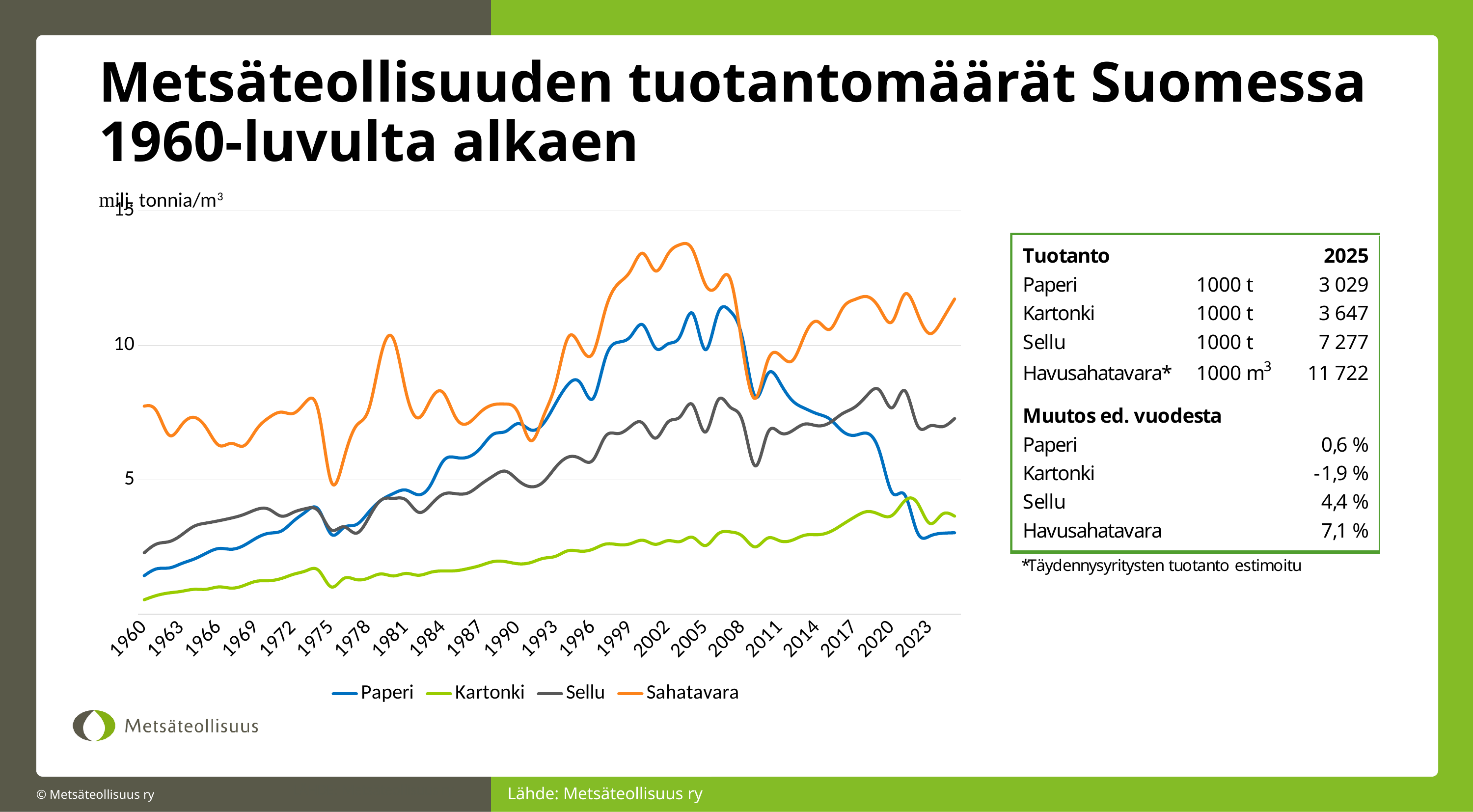
What kind of chart is shown on the slide? line chart Is the value for Sellu in 2023 greater or less than 5? greater Is the value for Kartonki in 1960 greater or less than 5? less Which series has the highest value in 2023? Sahatavara How many series does the chart legend list? 4 Which series are listed in the chart legend? Paperi, Kartonki, Sellu, Sahatavara Does the Paperi line rise or fall between 2008 and 2023? fall Which series has the lowest value in 1960? Kartonki In 2023, which is larger, the value for Sellu or the value for Paperi? Sellu What unit label is shown above the y axis of the chart? milj. tonnia/m³ Is the value for Sahatavara in 1960 greater or less than 5? greater